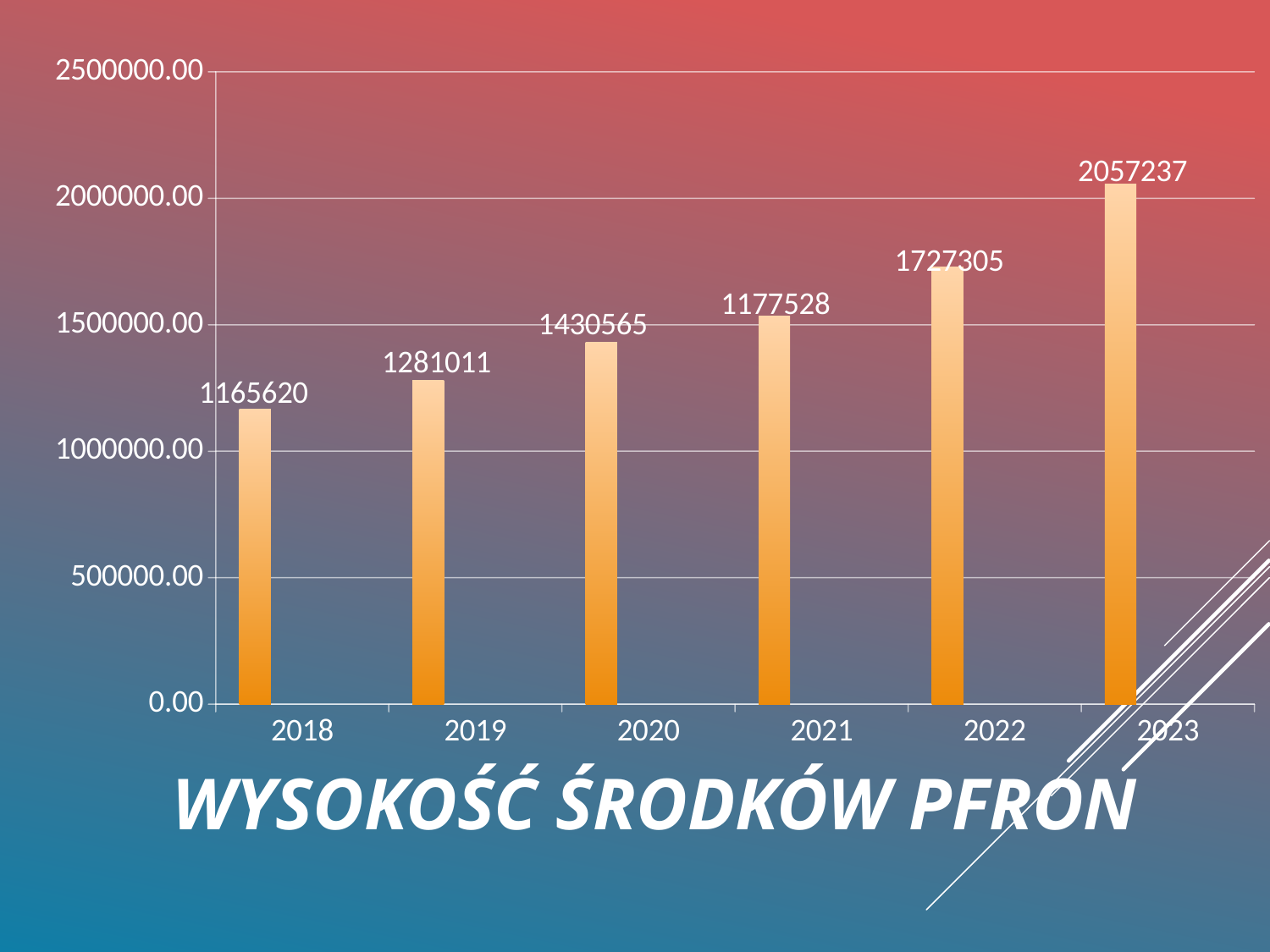
Is the value for 2023 greater or less than 2000000? greater What is the value shown for 2018? 1165620 What is the value shown for 2020? 1430565 What is the difference between the values for 2019 and 2018? 115391 Which is larger, the value for 2022 or the value for 2020? 2022 What is the value shown for 2023? 2057237 What is the difference between the values for 2023 and 2022? 329932 Which year has the lowest value? 2018 What is the value shown for 2022? 1727305 What kind of chart is shown on the slide? bar chart Which year has the highest value? 2023 How many years are shown on the x axis? 6